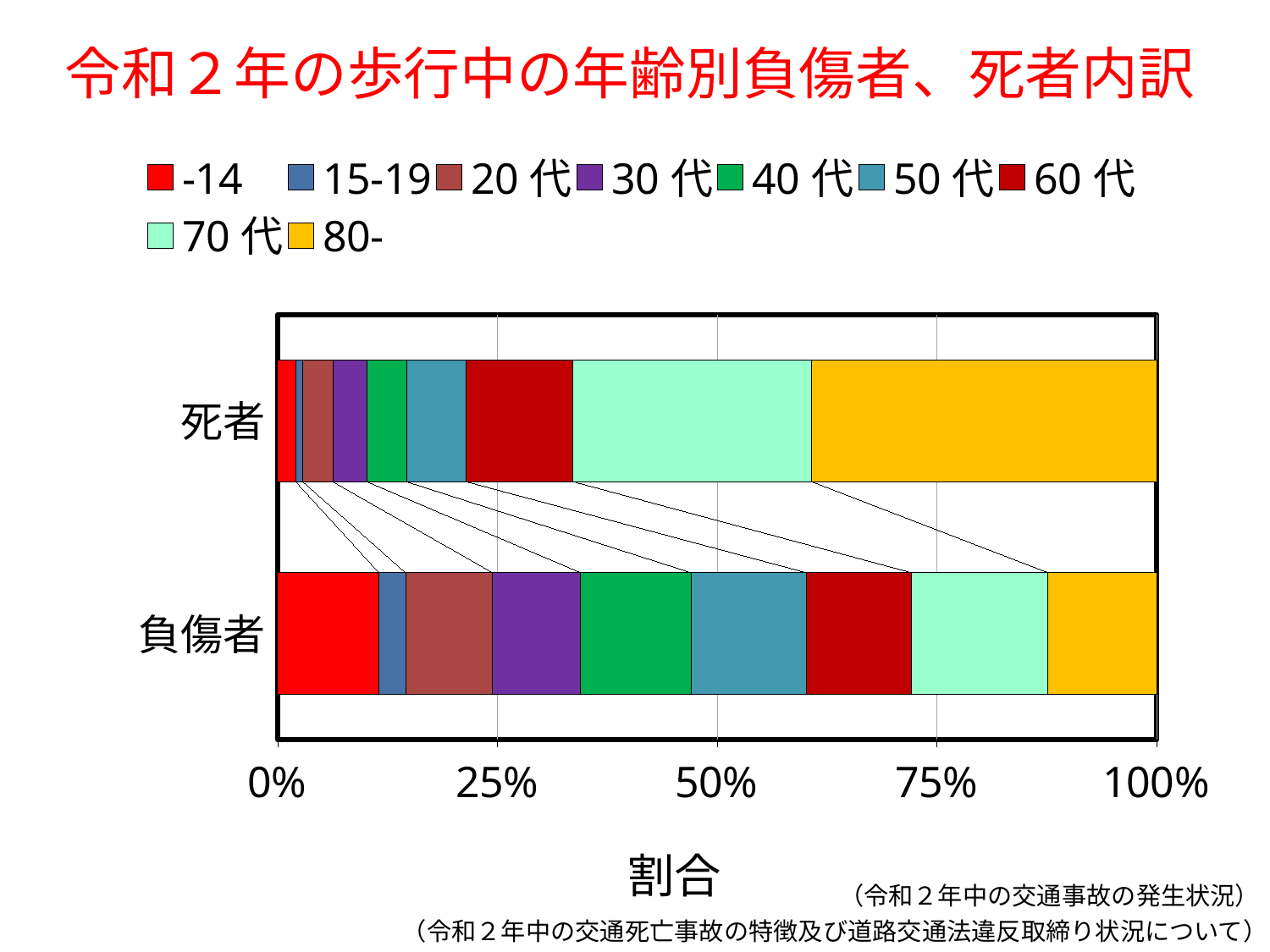
Which age group has the smallest share of the 死者 bar? 15-19 What is the title of the chart? 令和２年の歩行中の年齢別負傷者、死者内訳 How many categories (bars) are plotted on the chart? 2 Which age group has the smallest share of the 負傷者 bar? 15-19 Is the share of 80- in the 死者 bar greater or less than 25%? greater Is the share of 80- larger in the 死者 bar or the 負傷者 bar? 死者 What is the label of the horizontal axis? 割合 Is the share of -14 in the 負傷者 bar greater or less than 25%? less Which age group has the largest share of the 死者 bar? 80- How many series does the legend list? 9 Is the share of -14 larger in the 死者 bar or the 負傷者 bar? 負傷者 What kind of chart is shown on the slide? Stacked bar chart